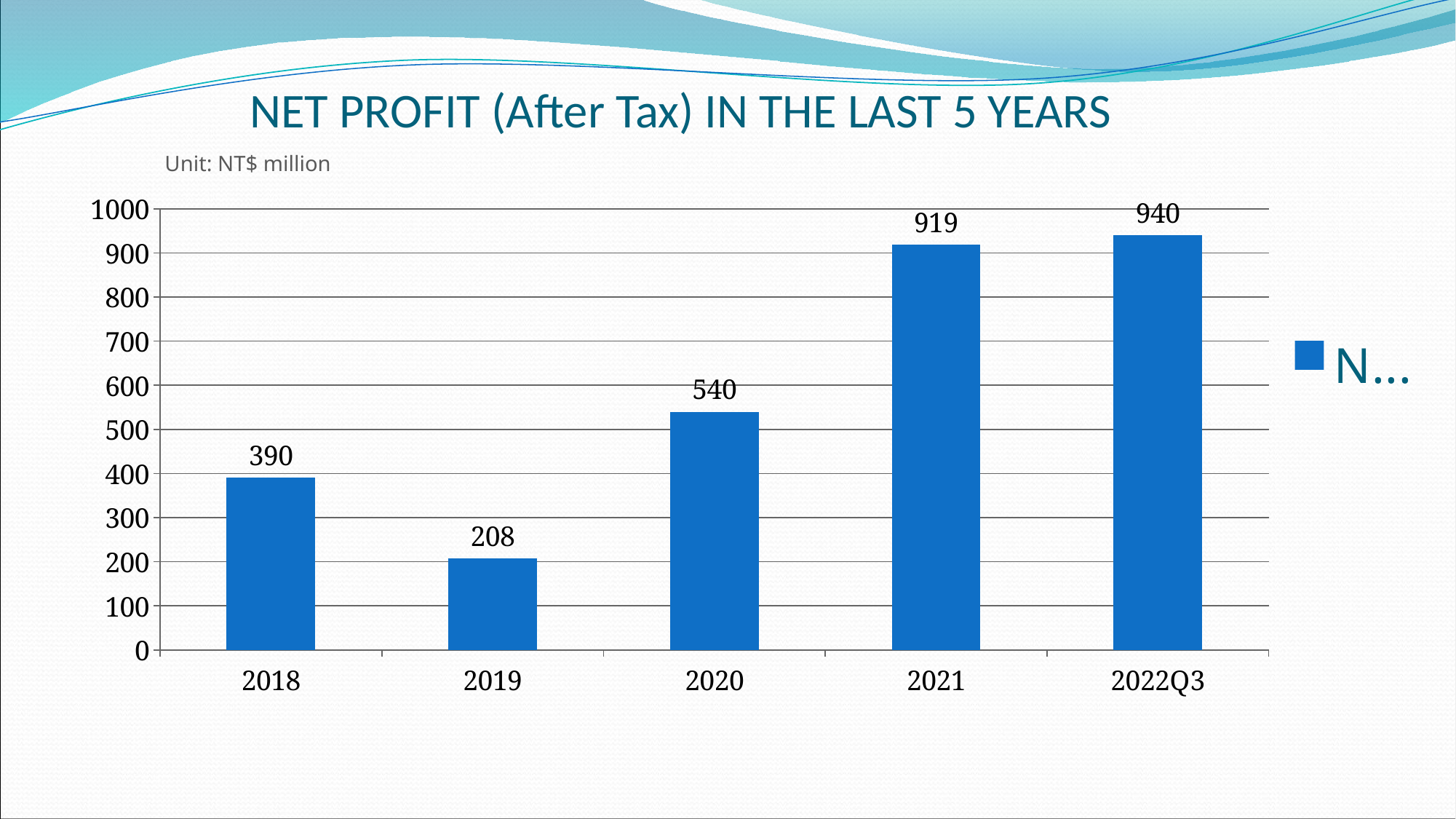
How many categories are shown on the x axis? 5 What is the net profit value for 2019? 208 What is the net profit value for 2020? 540 What is the net profit value for 2018? 390 What is the net profit value for 2021? 919 What is the difference between the net profit in 2021 and in 2020? 379 What kind of chart is shown on the slide? Bar chart Which is larger, the net profit for 2018 or for 2020? 2020 What is the net profit value for 2022Q3? 940 Which year has the highest net profit? 2022Q3 Which year has the lowest net profit? 2019 What unit is stated for the values in the chart? NT$ million